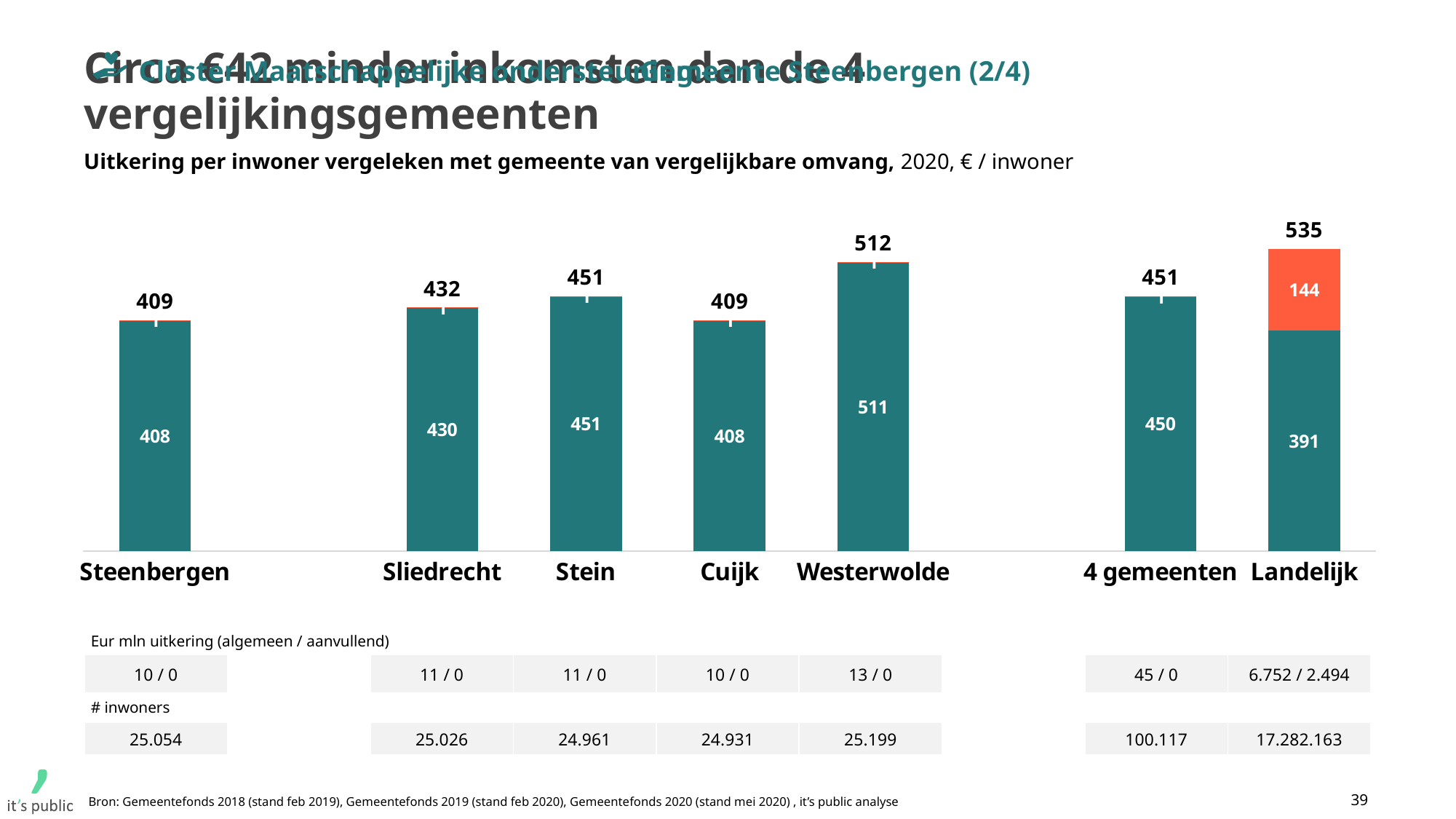
What is the total value shown above the bar for Westerwolde? 512 Which category has the highest total value? Landelijk What is the value of the teal segment of the Sliedrecht bar? 430 What is the difference between the total for Westerwolde and the total for Sliedrecht? 80 Which has a larger total value, Stein or Cuijk? Stein What is the difference between the total for Landelijk and the total for Steenbergen? 126 How many categories are shown on the x axis of the chart? 7 Which categories share the lowest total value of 409? Steenbergen and Cuijk What is the value of the orange (top) segment of the Landelijk bar? 144 What kind of chart is shown on the slide? Stacked bar chart What is the total value shown above the bar for Landelijk? 535 What is the value of the teal (bottom) segment of the Landelijk bar? 391